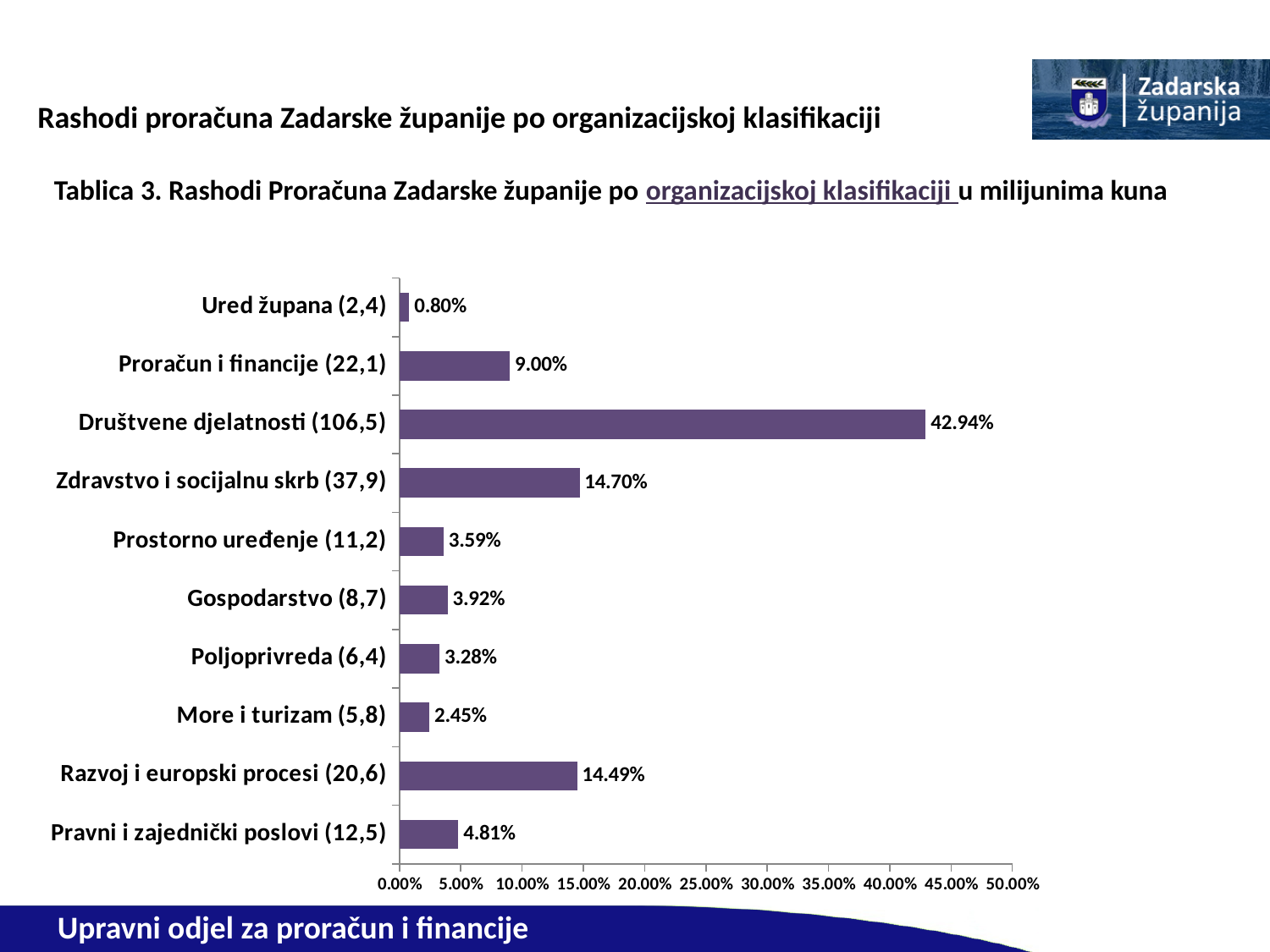
What percentage is shown for Razvoj i europski procesi (20,6)? 14.49% Is the value for Društvene djelatnosti (106,5) greater or less than 40.00%? greater Which category has the lowest percentage? Ured župana (2,4) How many categories are shown in the chart? 10 What is the highest value shown on the x axis? 50.00% What is the difference in percentage points between Proračun i financije (22,1) and Pravni i zajednički poslovi (12,5)? 4.19% What is the difference in percentage points between Zdravstvo i socijalnu skrb (37,9) and Razvoj i europski procesi (20,6)? 0.21% What percentage is shown for Društvene djelatnosti (106,5)? 42.94% What kind of chart is shown on the slide? Bar chart Which category has the highest percentage? Društvene djelatnosti (106,5) Which has a larger percentage, Gospodarstvo (8,7) or Poljoprivreda (6,4)? Gospodarstvo (8,7) What percentage is shown for Ured župana (2,4)? 0.80%